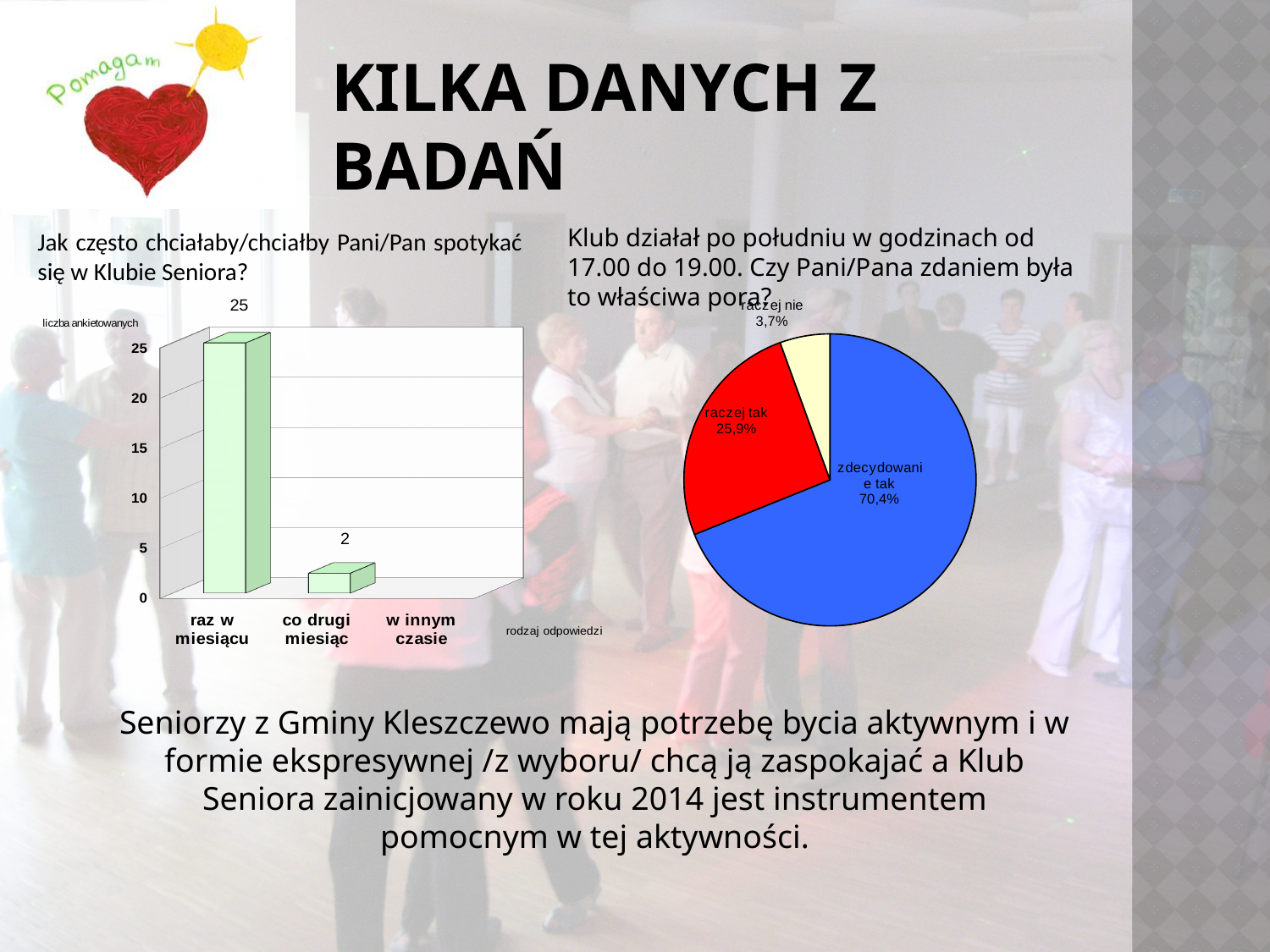
On the pie chart on the right, what share does "raczej tak" have? 25,9% What kind of chart is the chart on the left? bar chart On the bar chart on the left, what is the difference between the values for "raz w miesiącu" and "co drugi miesiąc"? 23 On the bar chart on the left, is the value for "raz w miesiącu" greater or less than 20? greater On the pie chart on the right, which slice is the smallest? raczej nie On the bar chart on the left, what is the value for "co drugi miesiąc"? 2 On the bar chart on the left, which category has the highest value? raz w miesiącu On the bar chart on the left, how many categories are shown on the x axis? 3 On the pie chart on the right, which is larger: "raczej tak" or "raczej nie"? raczej tak On the bar chart on the left, what is the value for "raz w miesiącu"? 25 On the pie chart on the right, what share does "zdecydowanie tak" have? 70,4% What kind of chart is the chart on the right? pie chart